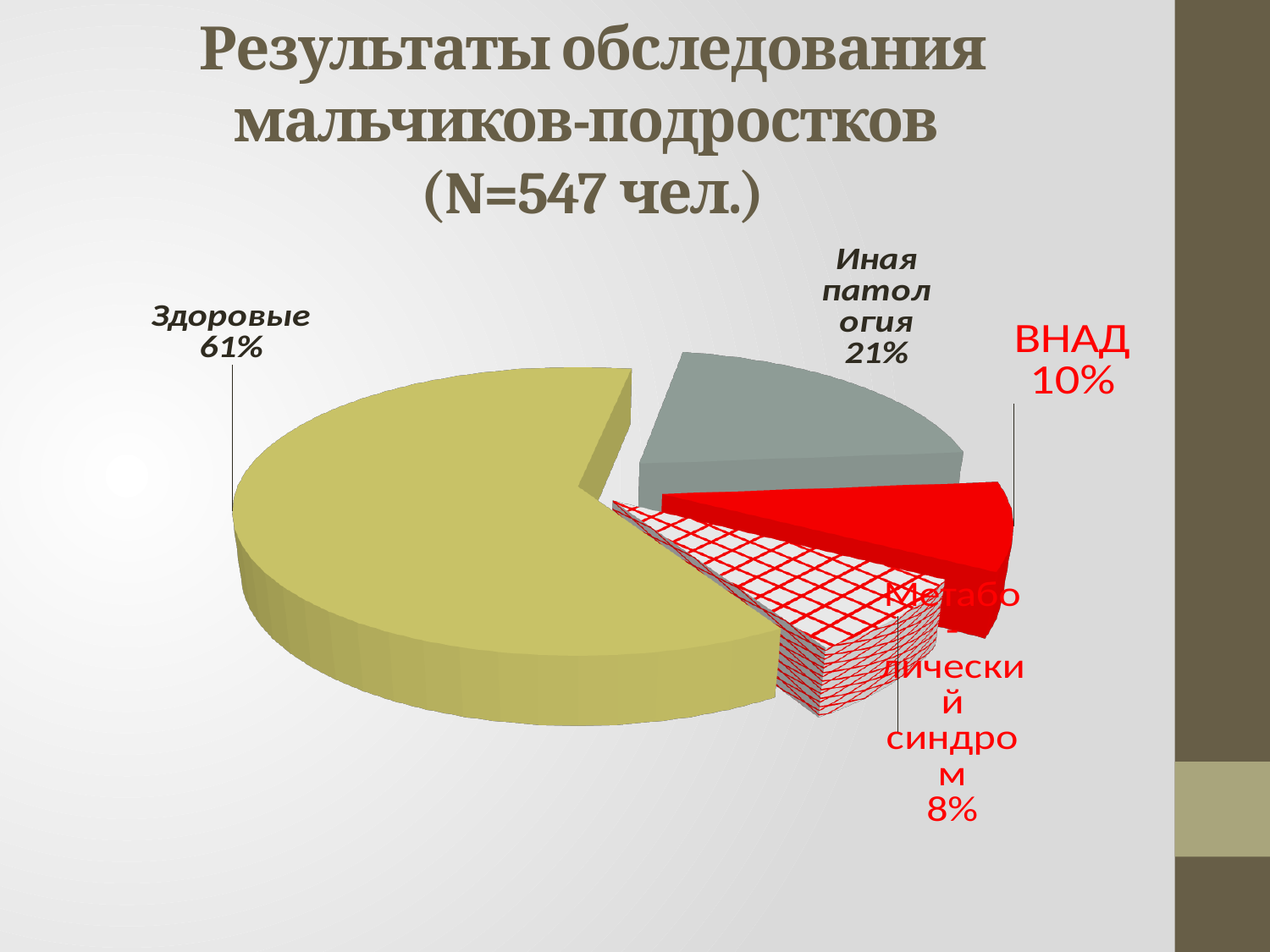
What share of the pie is labelled "Метаболический синдром"? 8% What is the difference between the shares for "Здоровые" and "Иная патология"? 40% What kind of chart is shown on the slide? pie chart What is the difference between the shares for "ВНАД" and "Метаболический синдром"? 2% What share of the pie is labelled "Здоровые"? 61% Which is larger, the share for "ВНАД" or the share for "Метаболический синдром"? ВНАД How many slices does the pie chart have? 4 What share of the pie is labelled "Иная патология"? 21% Which slice of the pie is the largest? Здоровые Which slice of the pie is the smallest? Метаболический синдром How many people (N) does the chart title say were examined? 547